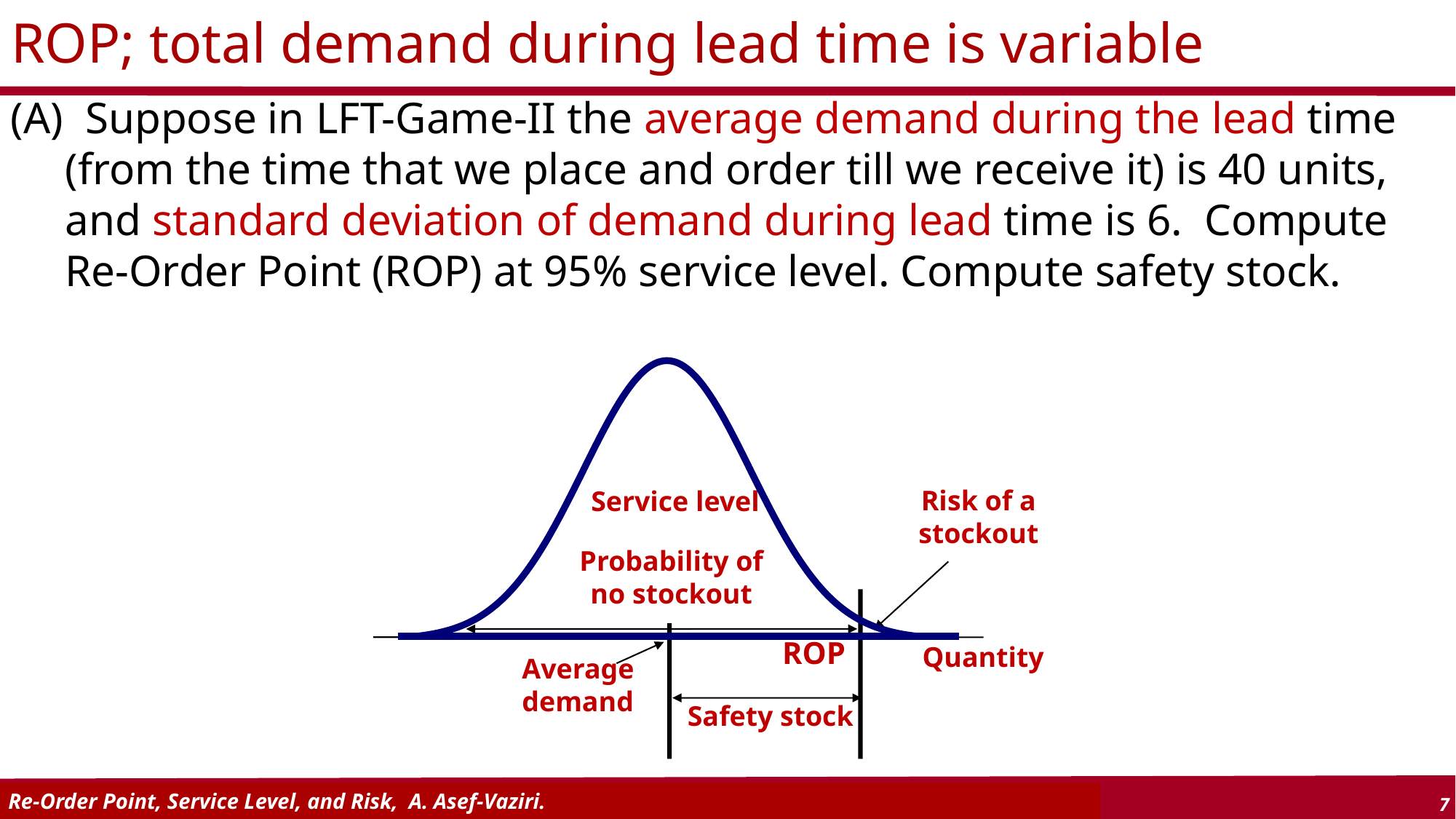
What is the label on the horizontal axis of the curve diagram? Quantity In the diagram, what does the distance between Average demand and ROP represent? Safety stock In the diagram, which is larger: the ROP or the average demand? ROP What kind of chart is shown on the slide? A normal distribution (bell) curve